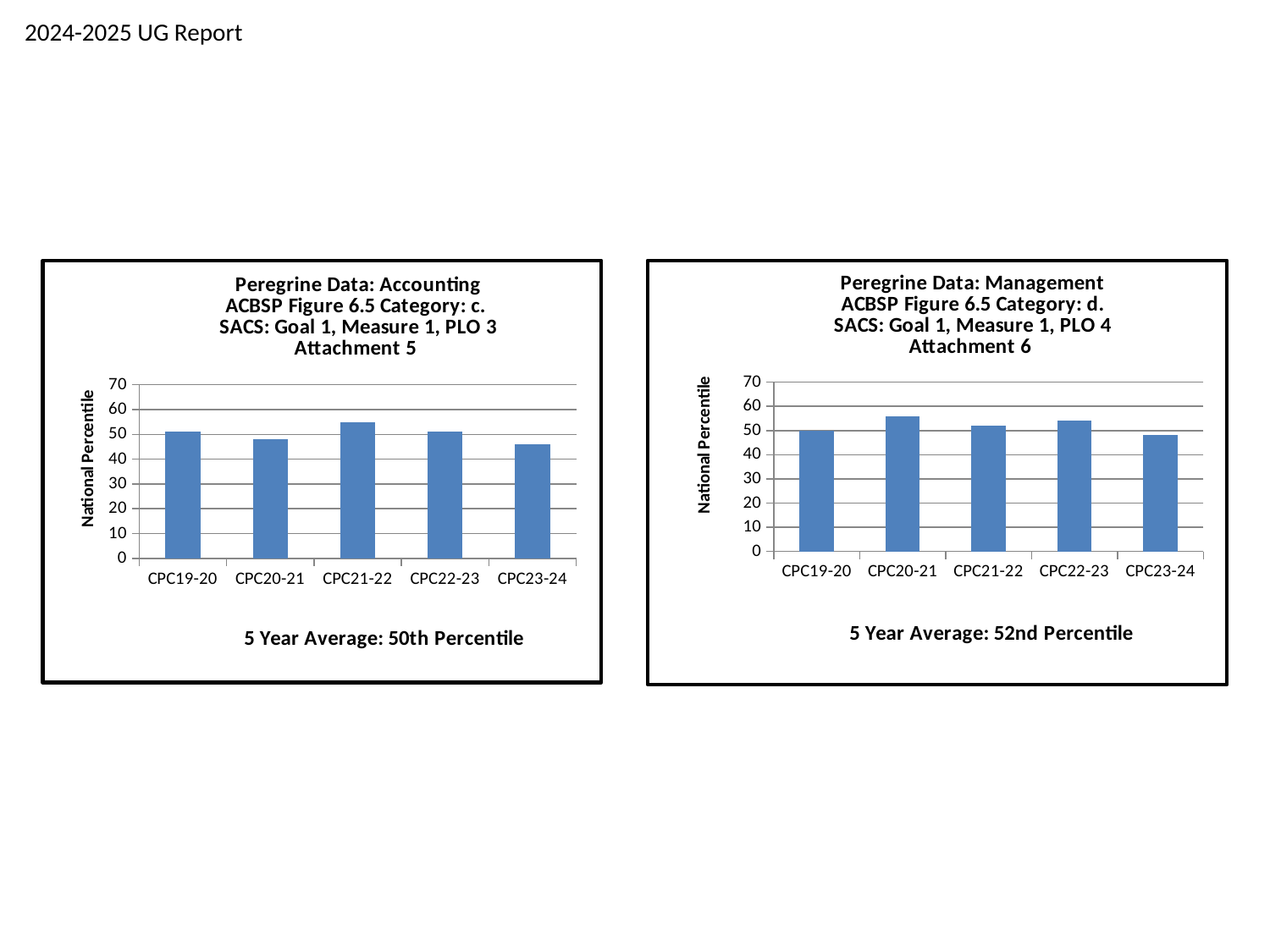
What is the y-axis label on the Peregrine Data: Accounting chart? National Percentile In the Peregrine Data: Management chart, which is larger, the value for CPC20-21 or the value for CPC23-24? CPC20-21 In the Peregrine Data: Management chart, is the value for CPC20-21 greater or less than 50? greater In the Peregrine Data: Management chart, is the value for CPC22-23 greater or less than 50? greater In the Peregrine Data: Accounting chart, is the value for CPC23-24 greater or less than 50? less In the Peregrine Data: Accounting chart, which is larger, the value for CPC21-22 or the value for CPC23-24? CPC21-22 What kind of chart is the Peregrine Data: Accounting chart? bar chart How many categories are shown on the x axis of the Peregrine Data: Management chart? 5 In the Peregrine Data: Accounting chart, which category has the highest value? CPC21-22 In the Peregrine Data: Management chart, which is larger, the value for CPC20-21 or the value for CPC19-20? CPC20-21 What 5 year average is stated below the Peregrine Data: Management chart? 52nd Percentile